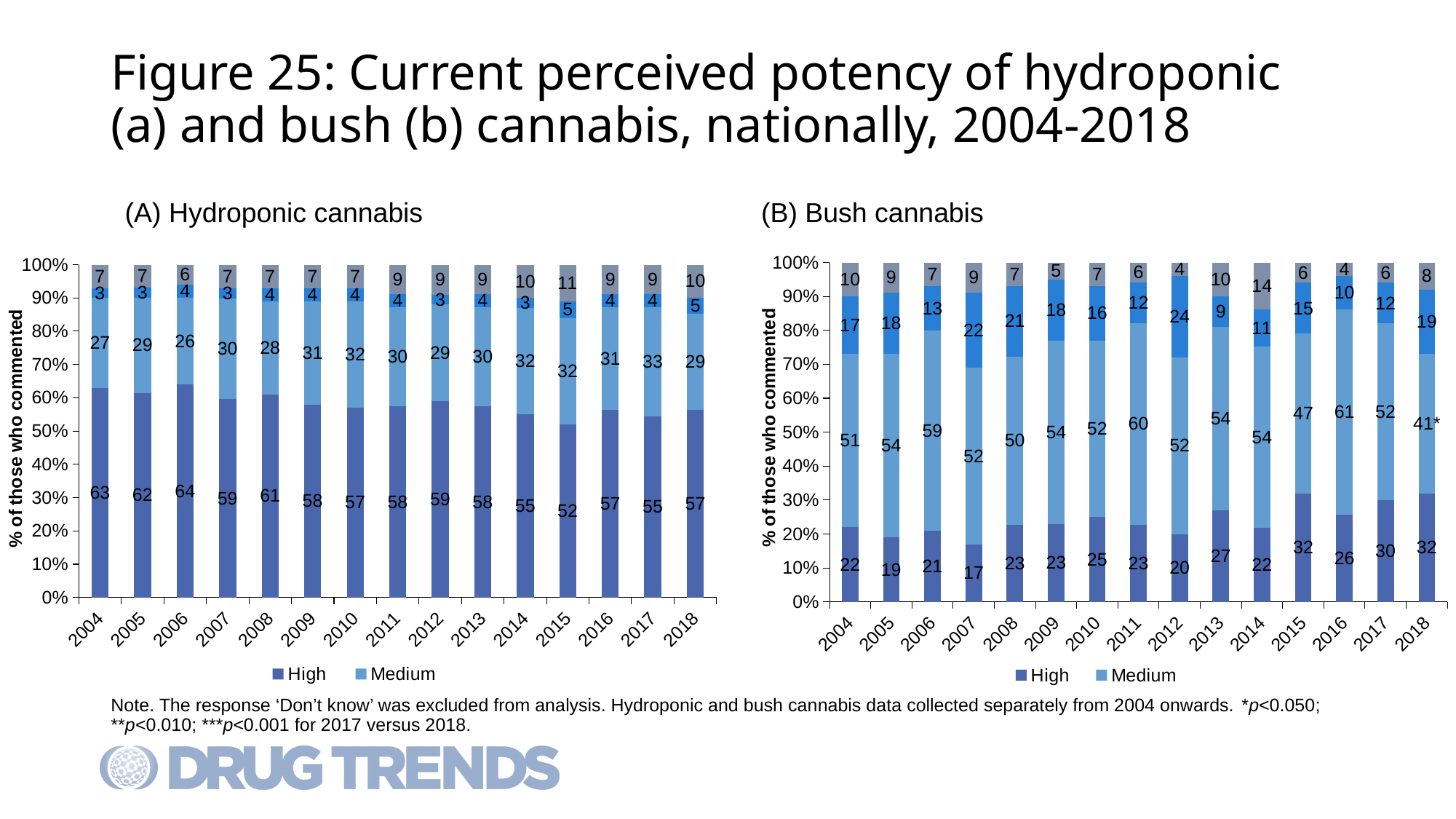
In chart (B) Bush cannabis, which year has the lowest value for High? 2007 In chart (A) Hydroponic cannabis, which year has the lowest value for High? 2015 What kind of chart is chart (B) Bush cannabis? Stacked bar chart In chart (B) Bush cannabis, which year has the larger Medium value, 2011 or 2012? 2011 What is the y-axis label of chart (A) Hydroponic cannabis? % of those who commented In chart (B) Bush cannabis, how many years are shown on the x axis? 15 In chart (A) Hydroponic cannabis, does the High value rise or fall overall from 2004 to 2018? Fall In chart (A) Hydroponic cannabis, how many series does the legend list? 2 In chart (A) Hydroponic cannabis, what is the value for High in 2004? 63 In chart (A) Hydroponic cannabis, what is the difference between the High value in 2004 and the High value in 2018? 6 In chart (A) Hydroponic cannabis, which year has the highest value for High? 2006 In chart (B) Bush cannabis, what is the value for Medium in 2016? 61